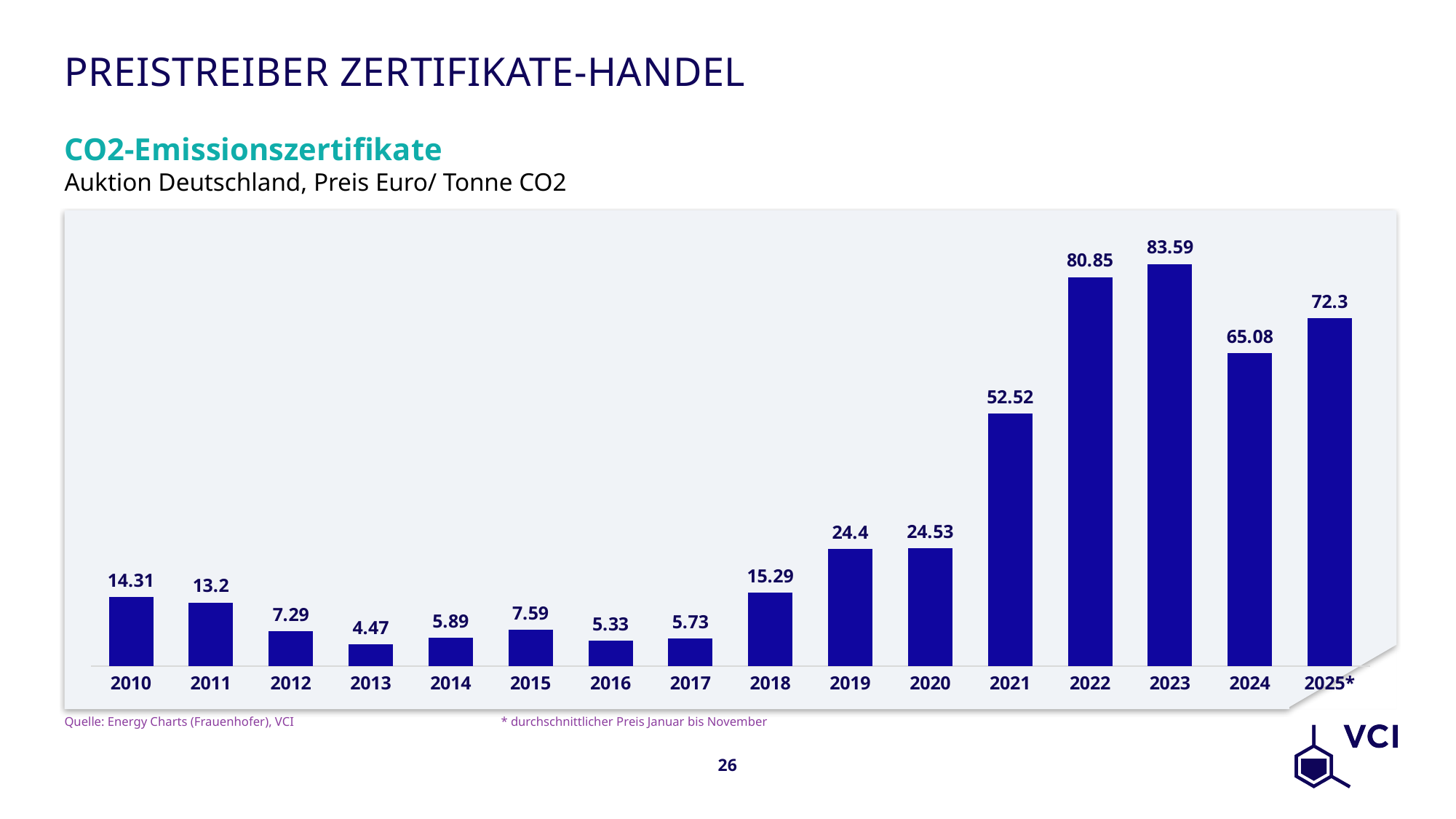
What kind of chart is shown on the slide? Bar chart What is the difference between the values for 2023 and 2024? 18.51 Which year has the lowest value? 2013 How many years are shown on the x axis? 16 Which is larger, the value for 2024 or the value for 2025*? 2025* Which is larger, the value for 2010 or the value for 2011? 2010 What is the value shown for 2025*? 72.3 Do the values generally rise or fall from 2017 to 2023? Rise What is the CO2 certificate price shown for 2021? 52.52 What is the difference between the values for 2022 and 2021? 28.33 Which year has the highest value? 2023 What is the value shown for 2013? 4.47